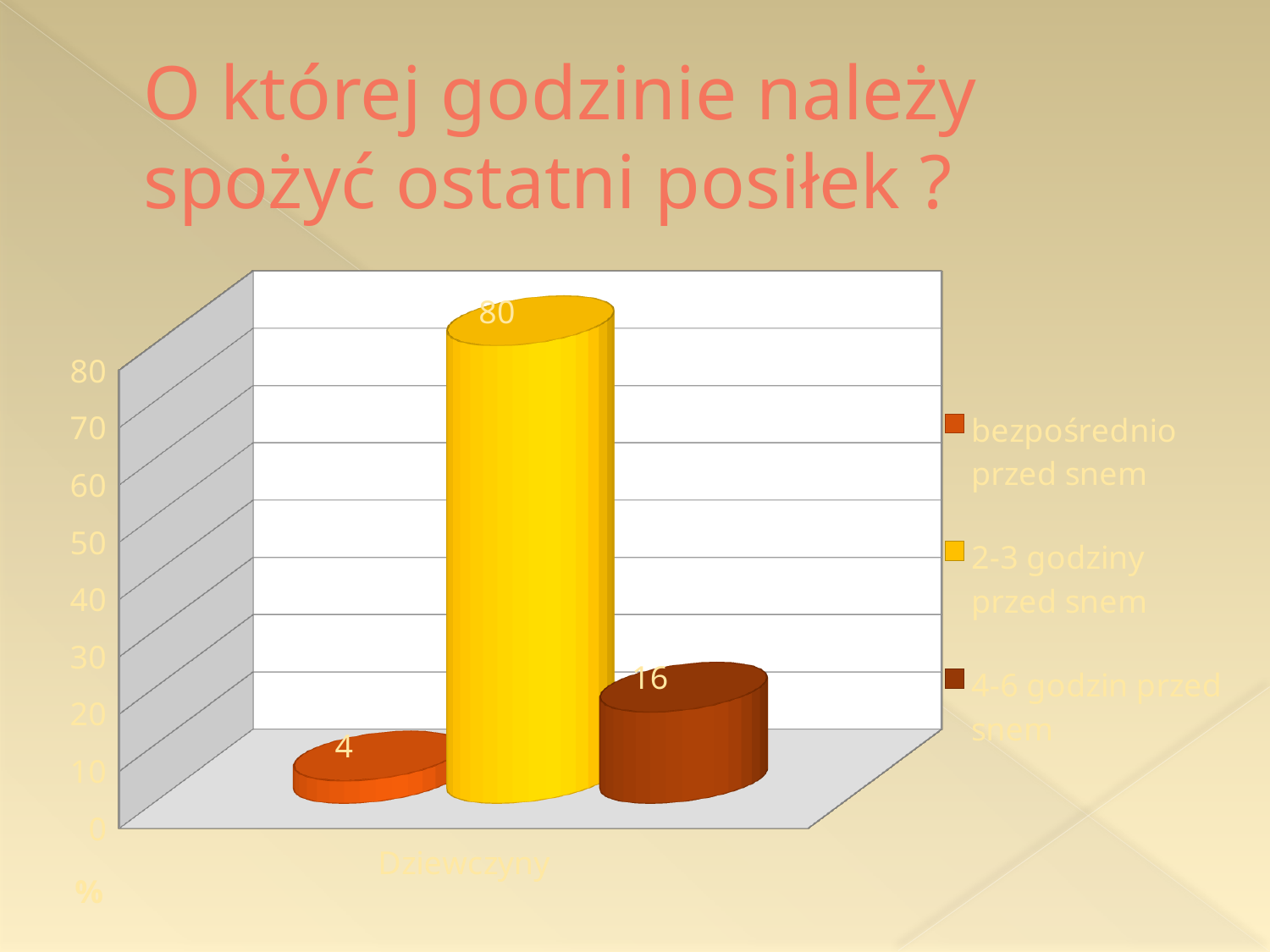
Which series has the highest value? 2-3 godziny przed snem What is the title of the slide? O której godzinie należy spożyć ostatni posiłek ? Which series has the lowest value? bezpośrednio przed snem What is the category label shown on the x axis? Dziewczyny What value is shown for "4-6 godzin przed snem"? 16 How many series does the legend list? 3 What is the difference between the values for "2-3 godziny przed snem" and "4-6 godzin przed snem"? 64 What is the difference between the values for "4-6 godzin przed snem" and "bezpośrednio przed snem"? 12 What value is shown for "bezpośrednio przed snem"? 4 What value is shown for "2-3 godziny przed snem"? 80 Which is larger, the value for "4-6 godzin przed snem" or the value for "bezpośrednio przed snem"? 4-6 godzin przed snem What kind of chart is shown on the slide? bar chart